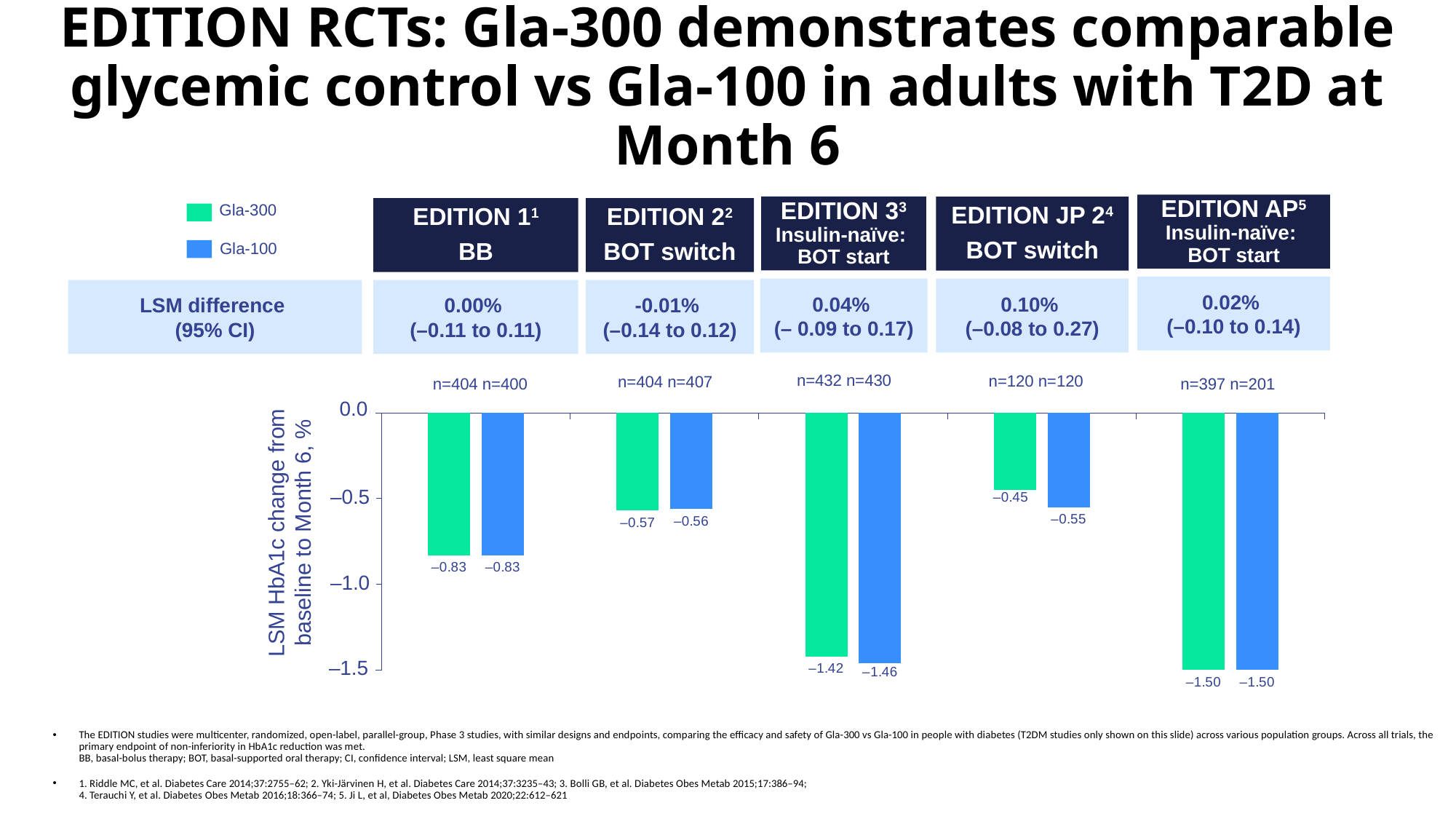
Which colour represents Gla-100 in the chart? Blue What is the difference between the Gla-300 and Gla-100 HbA1c changes in EDITION JP 2? 0.10 What is the LSM HbA1c change from baseline to Month 6 for Gla-100 in EDITION 3? −1.46 In which study does Gla-300 show the smallest reduction in HbA1c? EDITION JP 2 What is the LSM HbA1c change from baseline to Month 6 for Gla-300 in EDITION JP 2? −0.45 How many series does the legend list? 2 In which study does Gla-300 show the largest reduction in HbA1c? EDITION AP How many studies are shown on the chart? 5 What kind of chart is shown on the slide? Bar chart What is the LSM HbA1c change from baseline to Month 6 for Gla-100 in EDITION 2? −0.56 In EDITION 3, which treatment shows the larger HbA1c reduction, Gla-300 or Gla-100? Gla-100 What is the LSM HbA1c change from baseline to Month 6 for Gla-300 in EDITION 1? −0.83